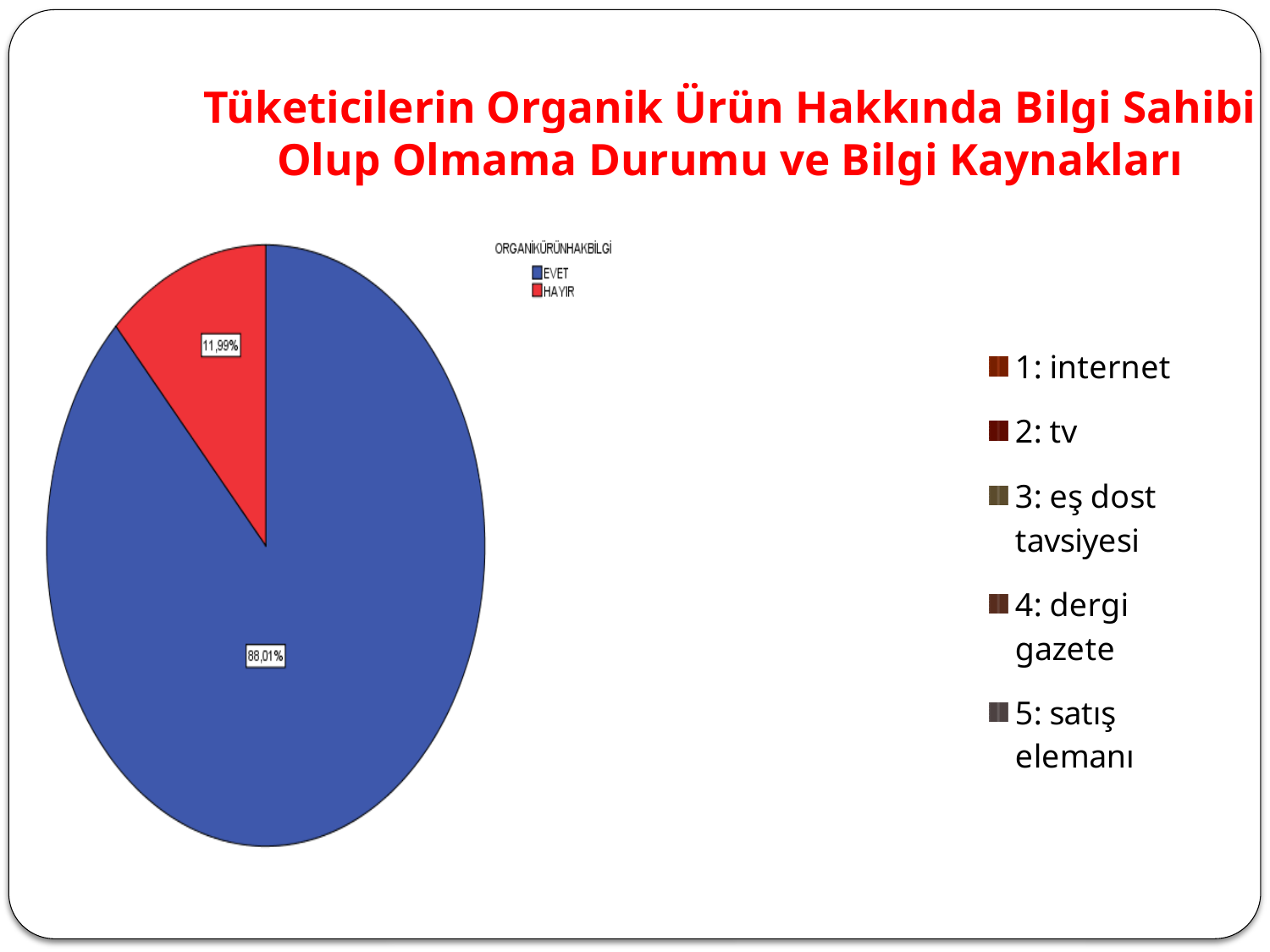
Which category has the largest slice in the pie chart? EVET What share of the pie does the HAYIR slice represent? 11,99% Which category has the smallest slice in the pie chart? HAYIR How many slices does the pie chart have? 2 What is the title shown above the pie chart's legend? ORGANİKÜRÜNHAKBİLGİ How many entries does the pie chart's legend list? 2 What type of chart is shown on the slide? pie chart What is the difference in percentage points between the EVET and HAYIR slices? 76,02% What percentage is shown for the EVET slice of the pie chart? 88,01% What percentage is shown for the HAYIR slice of the pie chart? 11,99% Which slice is larger, EVET or HAYIR? EVET What colour is the EVET slice in the pie chart? blue